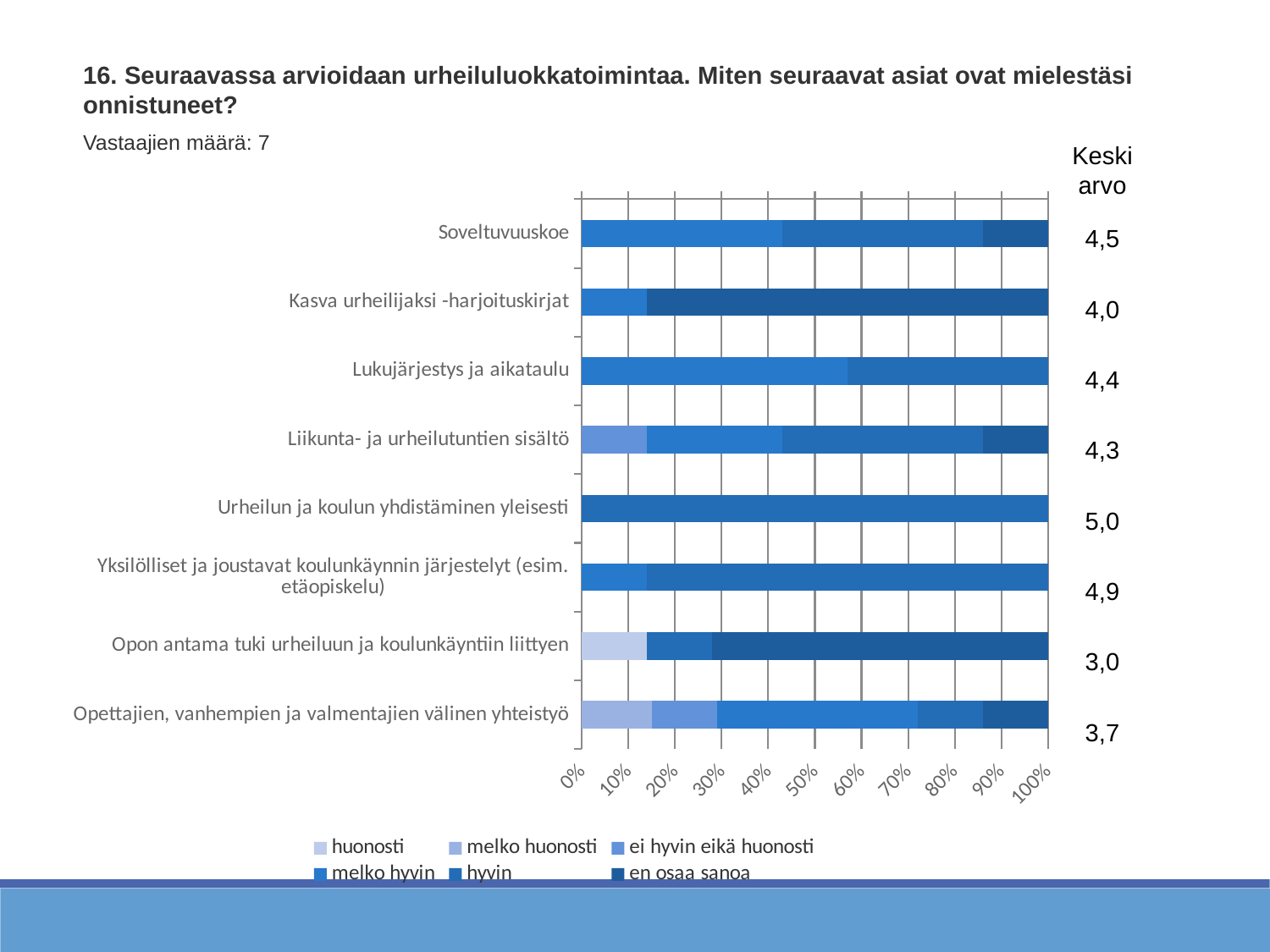
What kind of chart is shown on the slide? bar chart What is the difference between the highest and lowest Keskiarvo values? 2,0 What is the Keskiarvo value for Opon antama tuki urheiluun ja koulunkäyntiin liittyen? 3,0 Which has a higher Keskiarvo value, Soveltuvuuskoe or Lukujärjestys ja aikataulu? Soveltuvuuskoe Which category has the highest Keskiarvo value? Urheilun ja koulun yhdistäminen yleisesti Which category has the lowest Keskiarvo value? Opon antama tuki urheiluun ja koulunkäyntiin liittyen What is the Keskiarvo value for Opettajien, vanhempien ja valmentajien välinen yhteistyö? 3,7 How many respondents (Vastaajien määrä) does the slide report? 7 How many categories (rows) does the chart show? 8 What is the Keskiarvo value for Soveltuvuuskoe? 4,5 Is the first (leftmost) segment of the bar for Kasva urheilijaksi -harjoituskirjat greater or less than 20%? less How many series does the legend list? 6